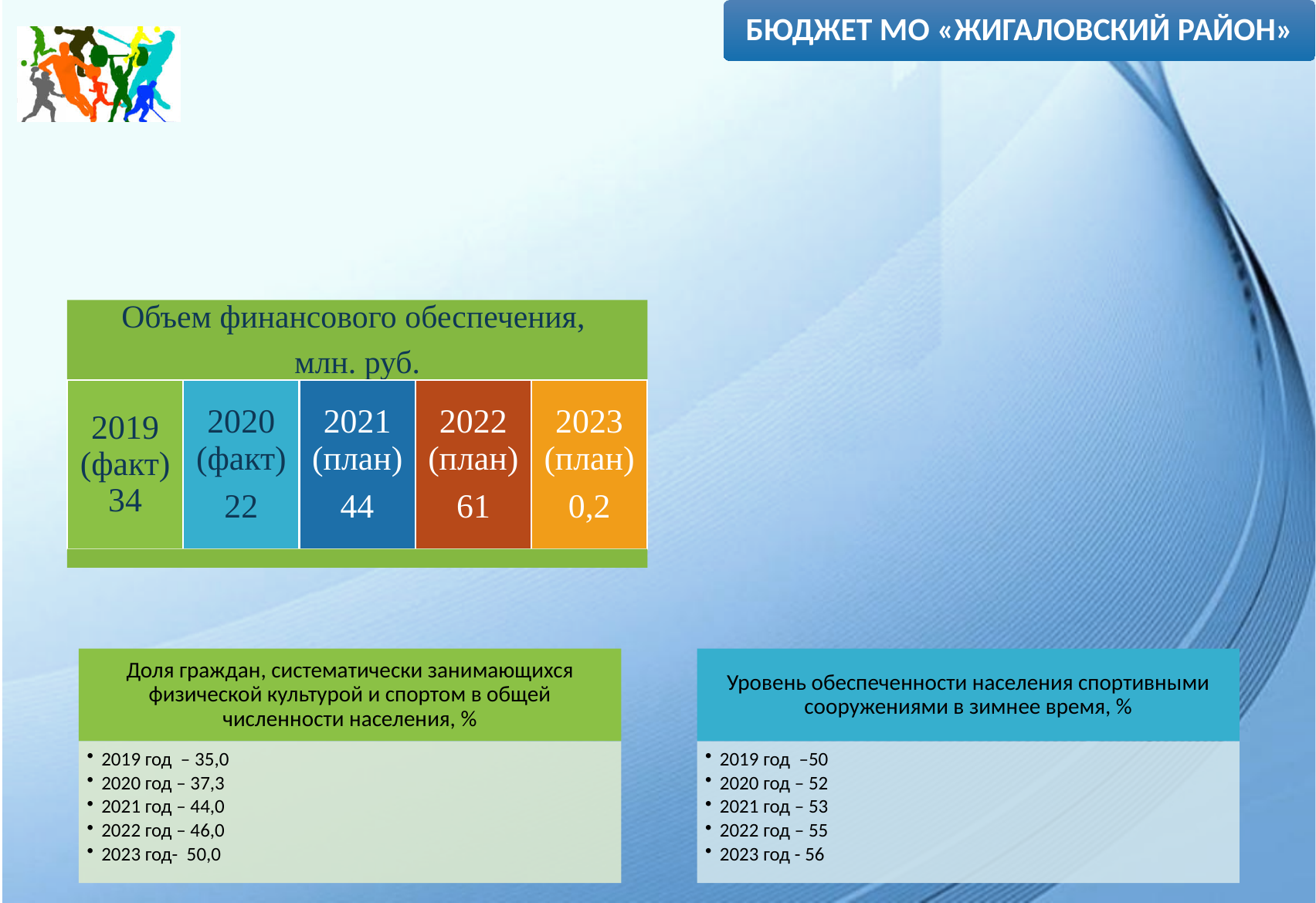
In the block titled «Объем финансового обеспечения, млн. руб.», what is the value for 2020 (факт)? 22 In the block titled «Объем финансового обеспечения, млн. руб.», what is the value for 2019 (факт)? 34 In the block titled «Объем финансового обеспечения, млн. руб.», which year has the lowest value? 2023 (план) In the block titled «Объем финансового обеспечения, млн. руб.», what is the value for 2021 (план)? 44 In the block titled «Объем финансового обеспечения, млн. руб.», what is the difference between the 2022 (план) and 2021 (план) values? 17 In the block titled «Объем финансового обеспечения, млн. руб.», what is the difference between the 2019 (факт) and 2020 (факт) values? 12 In the block titled «Объем финансового обеспечения, млн. руб.», what is the value for 2023 (план)? 0,2 In the block titled «Объем финансового обеспечения, млн. руб.», what colour is the 2022 (план) cell? Brown (dark orange) In the block titled «Объем финансового обеспечения, млн. руб.», which year has the highest value? 2022 (план) How many years are shown in the block titled «Объем финансового обеспечения, млн. руб.»? 5 In the block titled «Объем финансового обеспечения, млн. руб.», which is larger: the value for 2019 (факт) or 2020 (факт)? 2019 (факт) In the block titled «Объем финансового обеспечения, млн. руб.», what is the value for 2022 (план)? 61